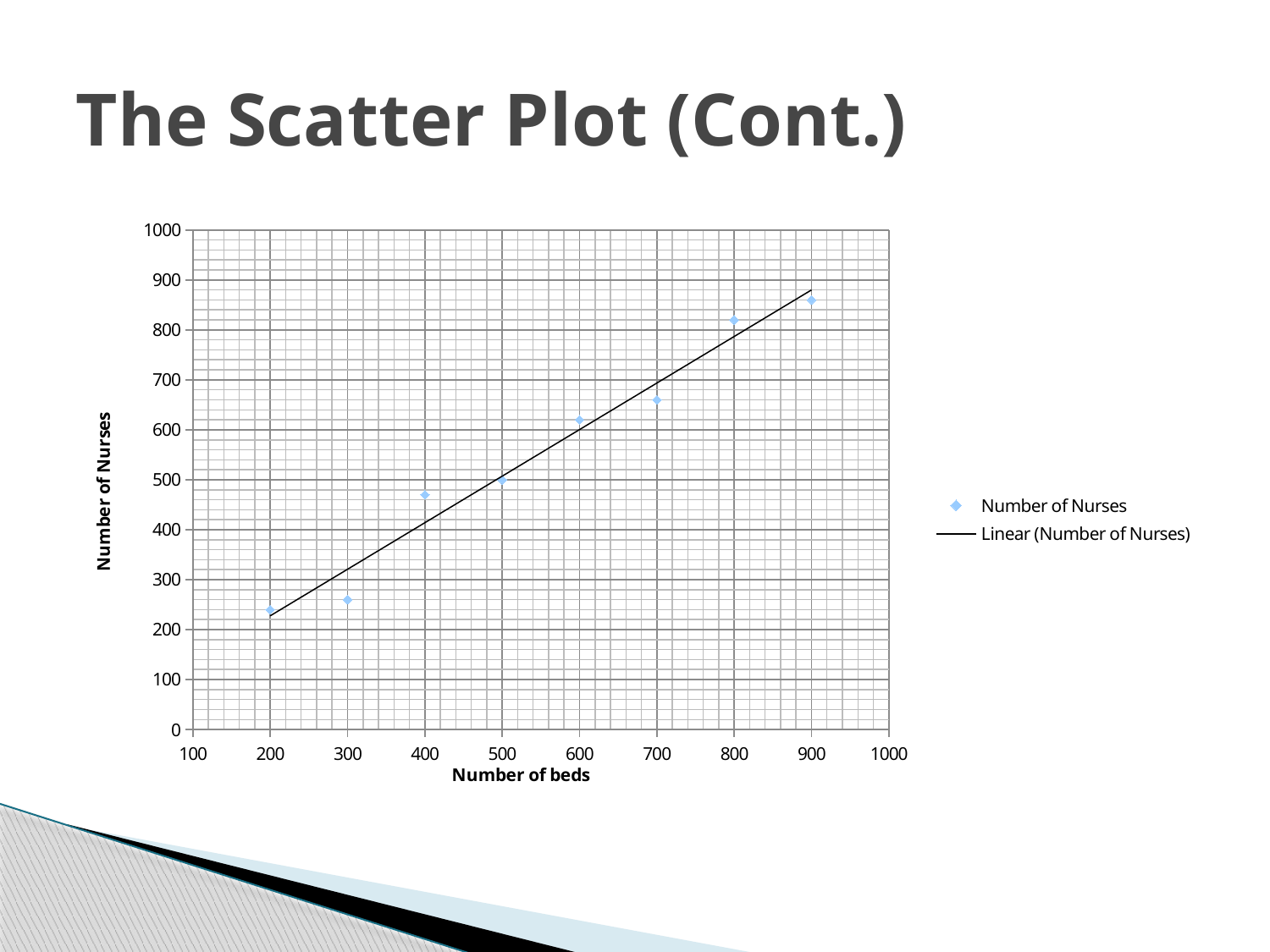
How many entries does the legend list? 2 What is the label of the x axis? Number of beds Does the number of nurses rise or fall as the number of beds increases? rise How many data points are plotted in the scatter plot? 8 What kind of chart is shown on the slide? scatter plot At which number of beds is the number of nurses highest? 900 What is the label of the y axis? Number of Nurses Is the number of nurses for 900 beds greater or less than 800? greater Which has more nurses: 400 beds or 300 beds? 400 beds Is the number of nurses for 700 beds greater or less than 600? greater Is the number of nurses for 200 beds greater or less than 300? less